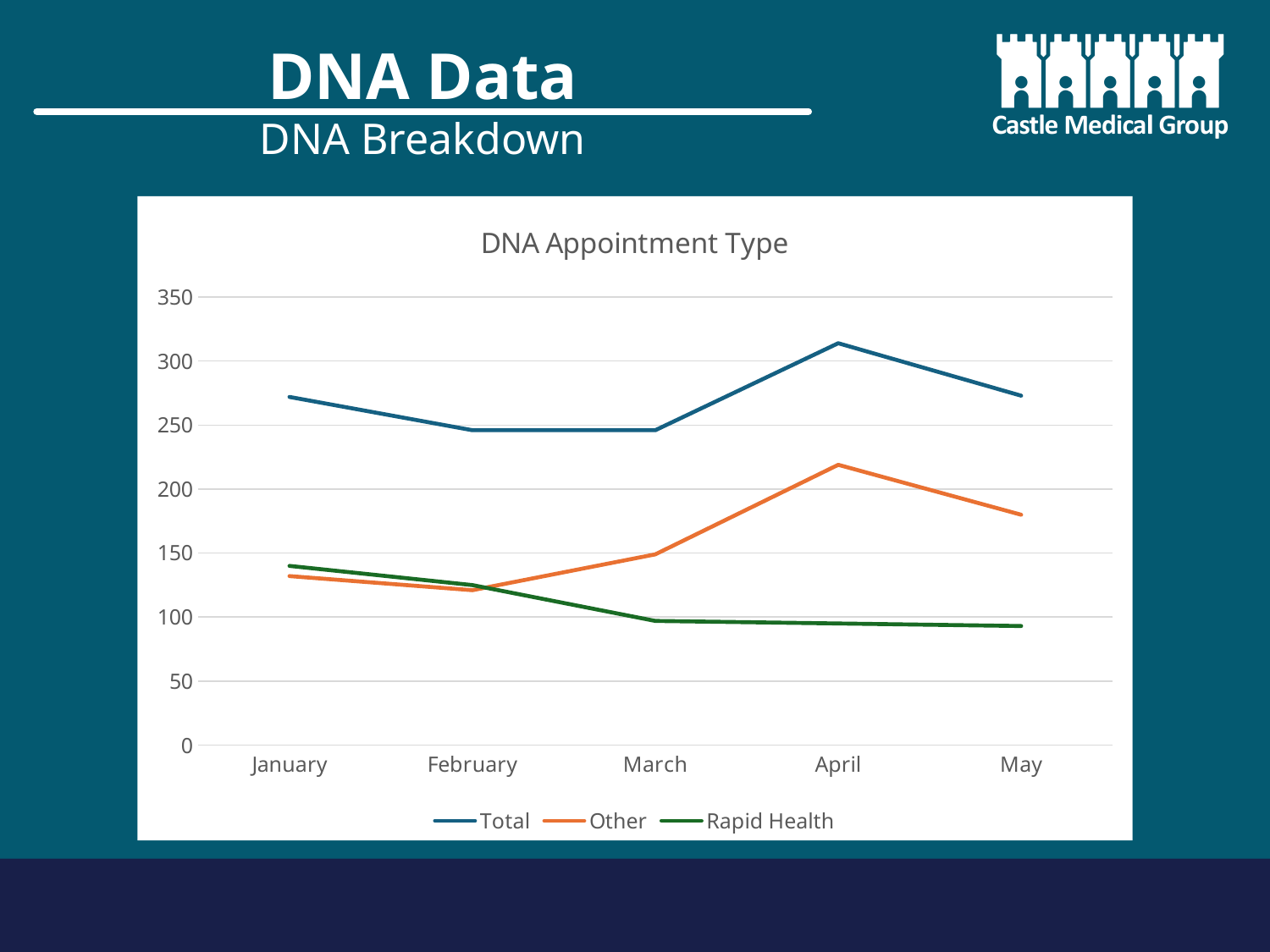
Does the Rapid Health series rise or fall from January to May? fall In which month is the Rapid Health series highest? January Is the Other value for February greater or less than 150? less What kind of chart is shown on the slide? line chart Is the Total value for April greater or less than 300? greater How many months are shown on the x axis? 5 Is the Rapid Health value for January greater or less than 100? greater In which month is the Total series highest? April In April, which is larger: the Other value or the Rapid Health value? Other How many series does the legend list? 3 In which month is the Other series highest? April What is the title of the chart? DNA Appointment Type